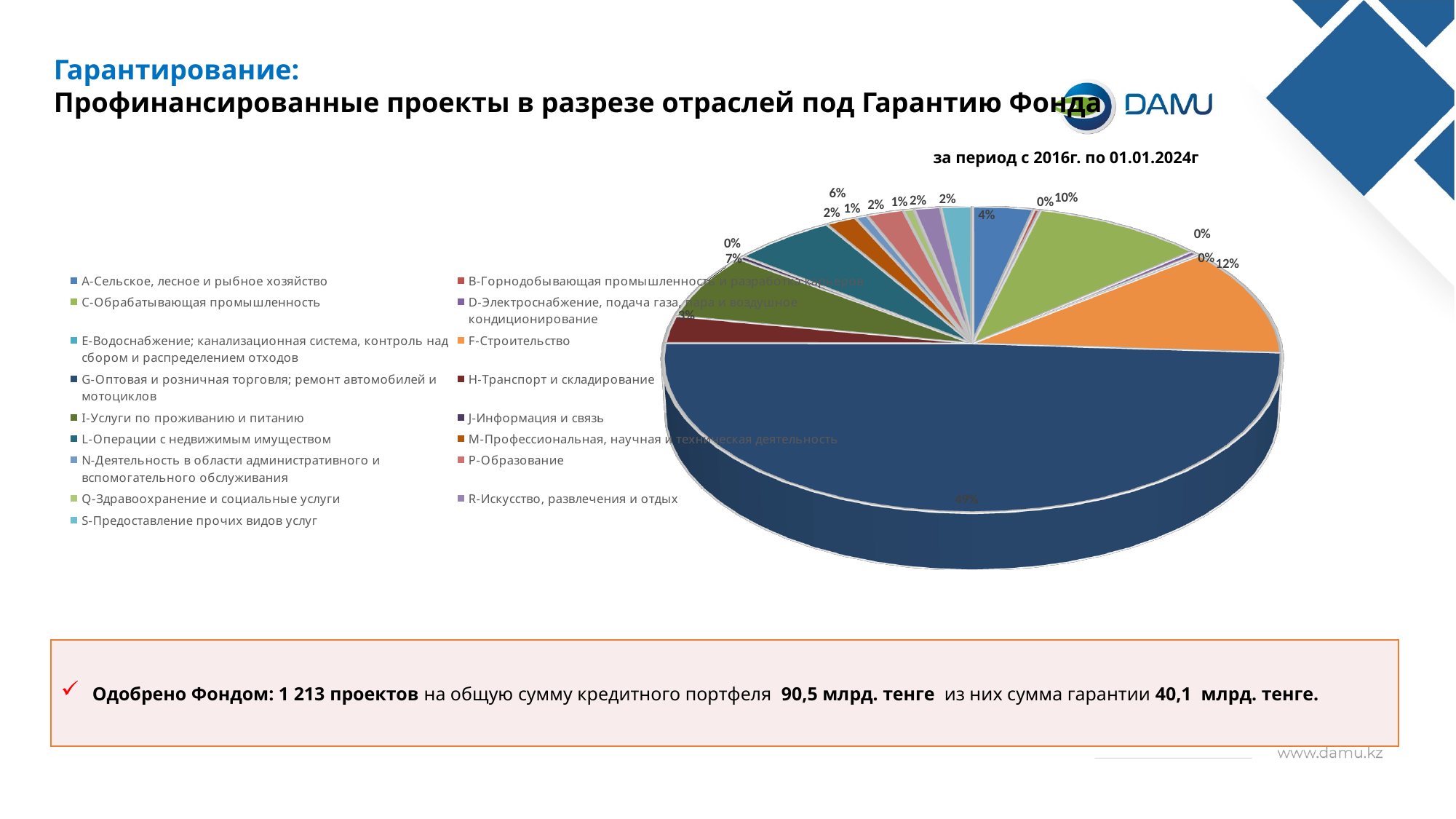
Which is larger, the slice for G-Оптовая и розничная торговля or the slice for F-Строительство? G-Оптовая и розничная торговля; ремонт автомобилей и мотоциклов What share of the pie does F-Строительство have? 12% What period does the chart cover, according to the text above it? за период с 2016г. по 01.01.2024г What kind of chart is shown on the slide? pie chart What colour is the slice for G-Оптовая и розничная торговля; ремонт автомобилей и мотоциклов? dark blue Which sector has the largest slice of the pie? G-Оптовая и розничная торговля; ремонт автомобилей и мотоциклов What is the difference between the shares of F-Строительство and C-Обрабатывающая промышленность? 2% How many sectors does the legend list? 17 What share of the pie does C-Обрабатывающая промышленность have? 10% What share of the pie does A-Сельское, лесное и рыбное хозяйство have? 4% Which is larger, the slice for F-Строительство or the slice for C-Обрабатывающая промышленность? F-Строительство